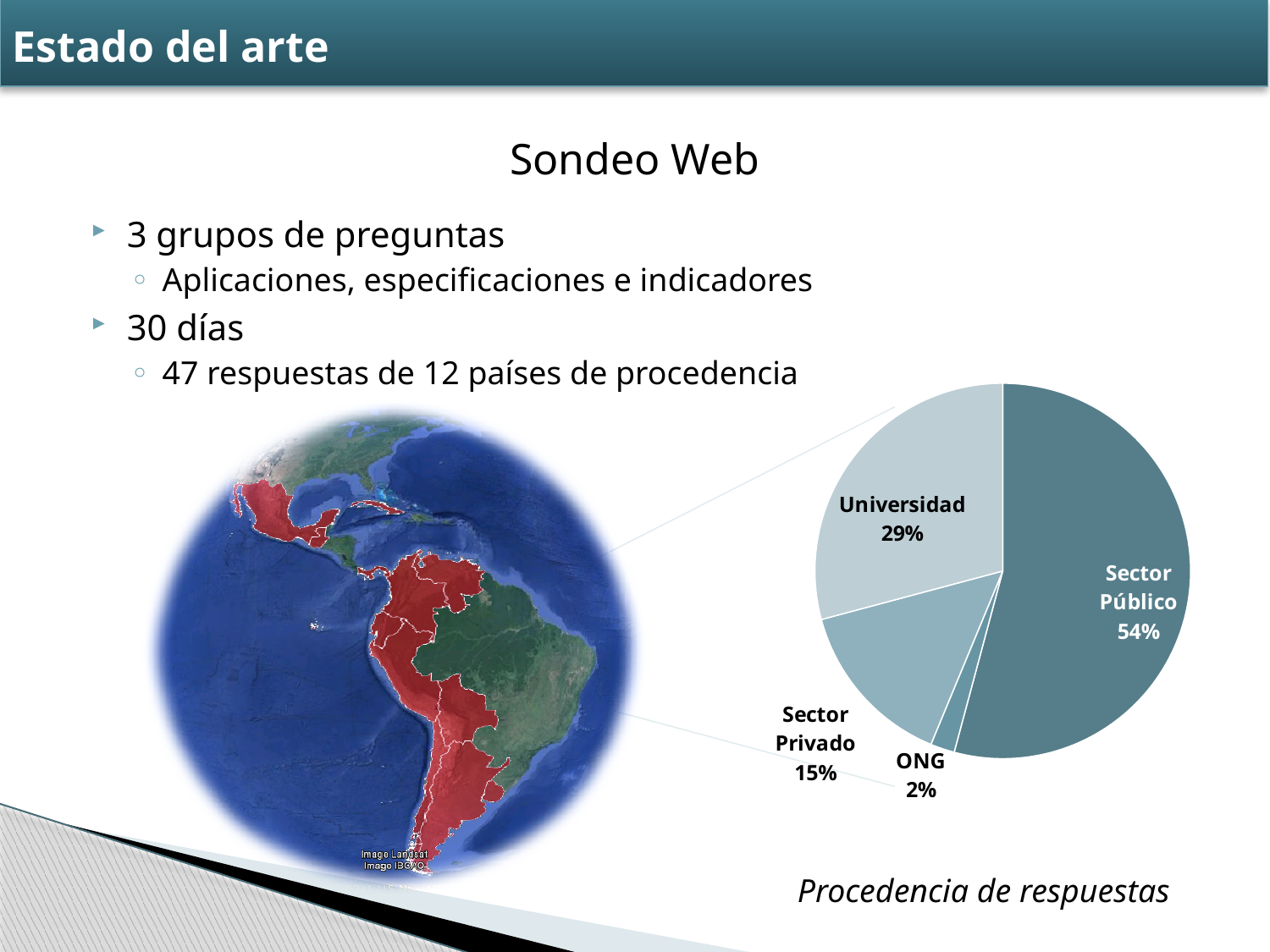
Which category has the largest share of responses? Sector Público What is the difference in percentage points between Sector Público and Universidad? 25 What share of responses comes from ONG? 2% What kind of chart is shown on the slide? Pie chart What is the difference in percentage points between Sector Privado and ONG? 13 What share of responses comes from Sector Privado? 15% What share of responses comes from Universidad? 29% Which is larger, the share for Universidad or the share for Sector Privado? Universidad What share of responses comes from Sector Público? 54% Which category has the smallest share of responses? ONG How many categories are shown in the pie chart? 4 What is the caption below the pie chart? Procedencia de respuestas